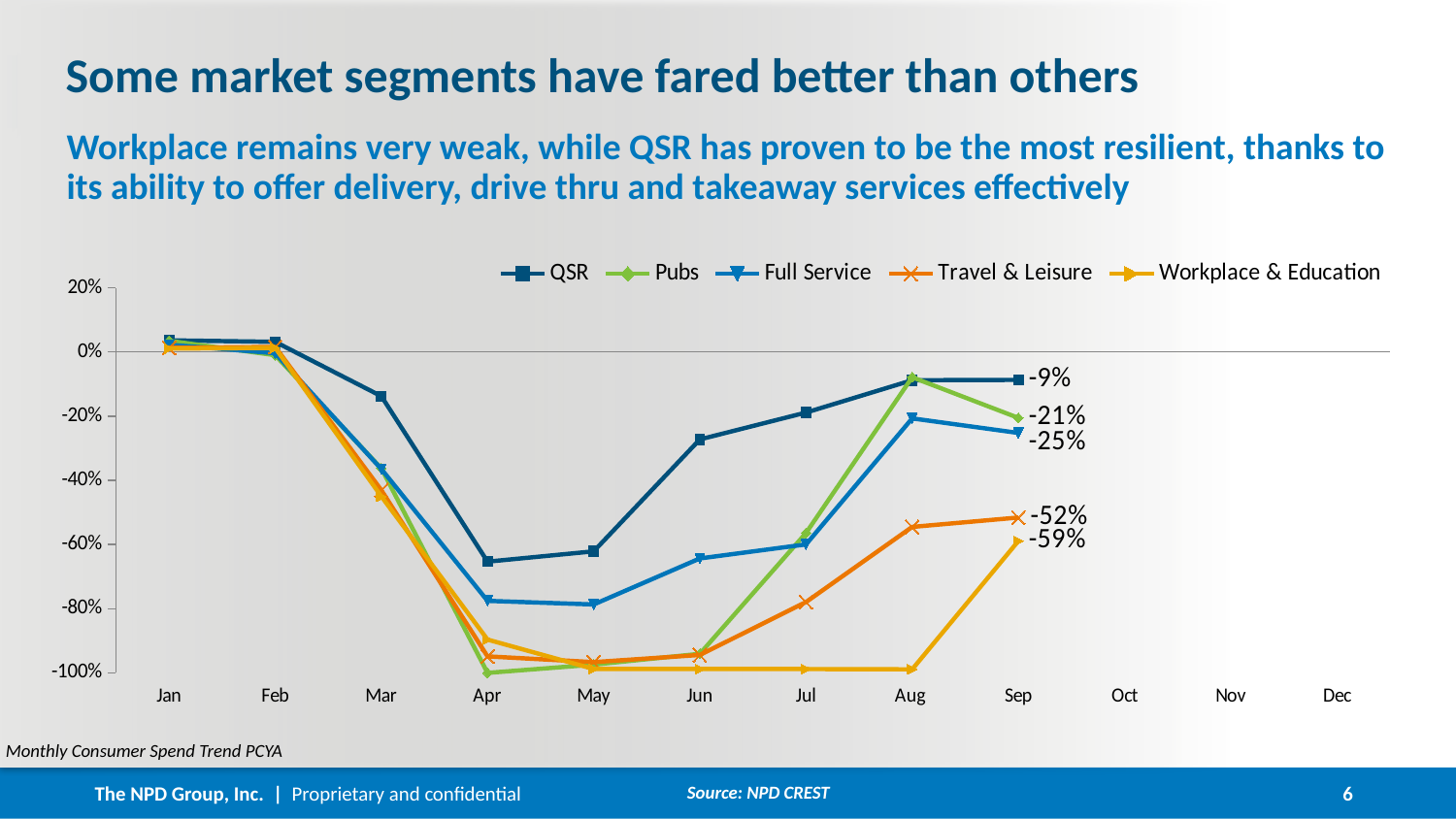
Which series has the highest value in Sep? QSR Which series has the lowest value in Sep? Workplace & Education How many series does the legend list? 5 What is the value for Workplace & Education in Sep? -59% What type of chart is shown on the slide? line chart What is the value for Full Service in Sep? -25% Which series is shown in orange in the legend? Travel & Leisure Is the value for QSR in Apr greater or less than -40%? less What is the value for Travel & Leisure in Sep? -52% What is the difference between the Sep values for QSR and Workplace & Education? 50 percentage points What is the value for Pubs in Sep? -21% What is the value for QSR in Sep? -9%